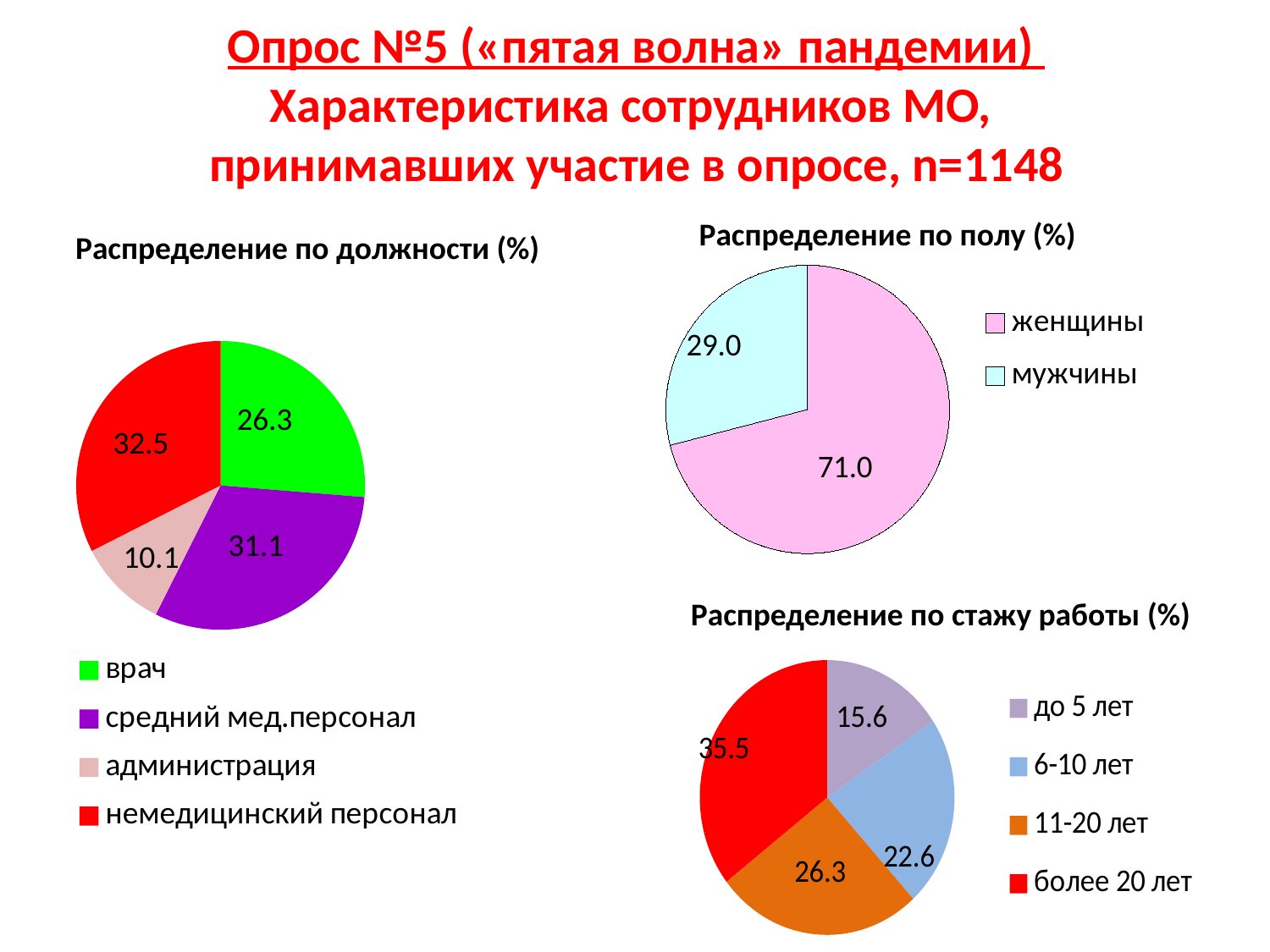
What type of chart is 'Распределение по должности (%)'? pie chart In the chart 'Распределение по стажу работы (%)', which category has the largest share? более 20 лет How many categories are shown in the chart 'Распределение по стажу работы (%)'? 4 In the chart 'Распределение по должности (%)', which category has the smallest share? администрация In the chart 'Распределение по полу (%)', how many series does the legend list? 2 In the chart 'Распределение по стажу работы (%)', what is the value for '6-10 лет'? 22.6 In the chart 'Распределение по полу (%)', which is larger, 'женщины' or 'мужчины'? женщины In the chart 'Распределение по должности (%)', which category has the largest share? немедицинский персонал In the chart 'Распределение по должности (%)', what is the difference between 'средний мед.персонал' and 'администрация'? 21.0 In the chart 'Распределение по должности (%)', what is the value for 'врач'? 26.3 In the chart 'Распределение по стажу работы (%)', what is the difference between 'более 20 лет' and 'до 5 лет'? 19.9 In the chart 'Распределение по полу (%)', what is the value for 'мужчины'? 29.0